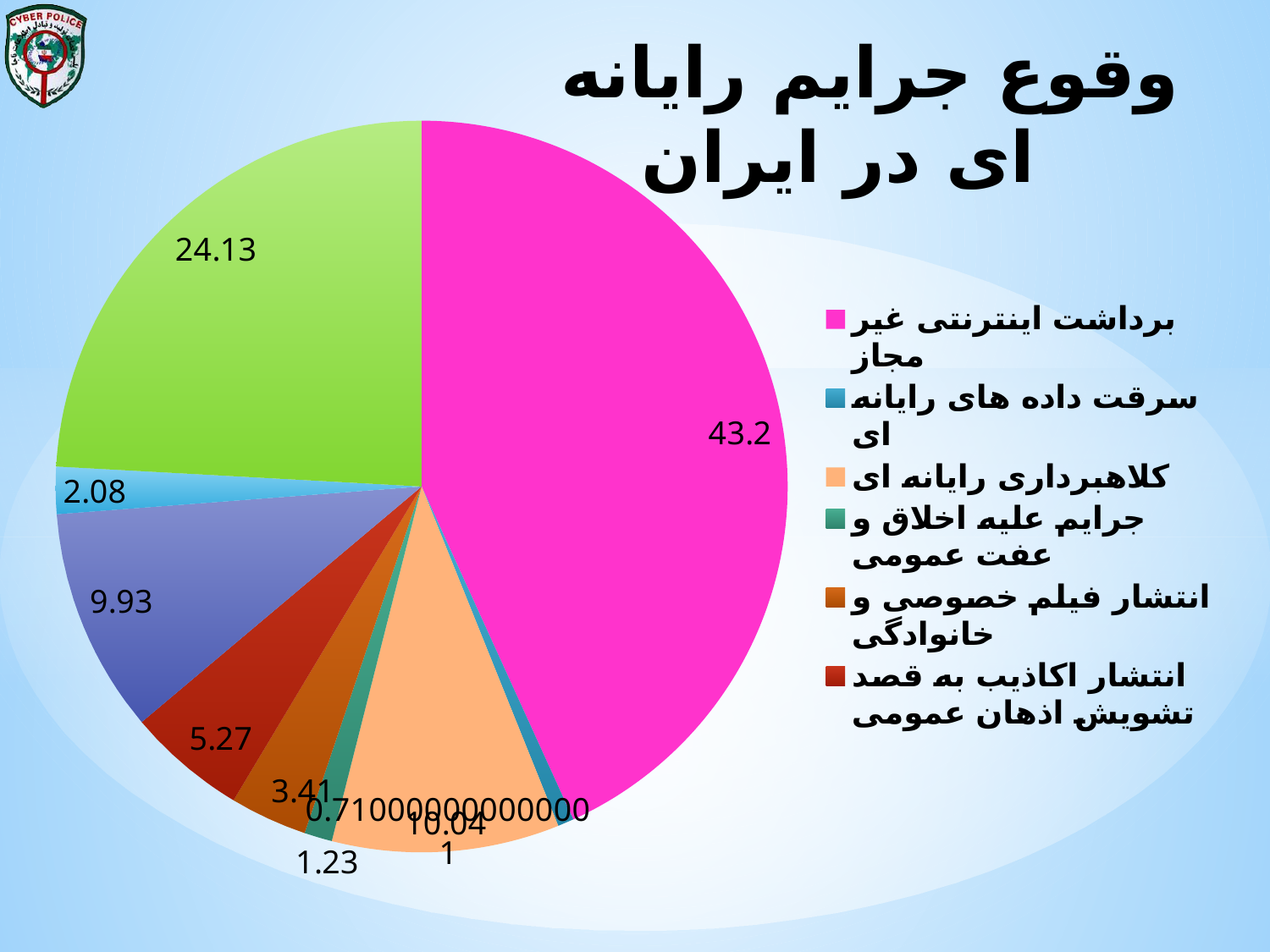
Which is larger, the slice for برداشت اینترنتی غیر مجاز or the slice for کلاهبرداری رایانه ای? برداشت اینترنتی غیر مجاز What kind of chart is shown on the slide? pie chart What is the value shown for انتشار فیلم خصوصی و خانوادگی? 3.41 What is the difference between the values for انتشار اکاذیب به قصد تشویش اذهان عمومی and انتشار فیلم خصوصی و خانوادگی? 1.86 What is the value shown for انتشار اکاذیب به قصد تشویش اذهان عمومی? 5.27 What is the difference between the values for برداشت اینترنتی غیر مجاز and کلاهبرداری رایانه ای? 33.16 What is the value shown for کلاهبرداری رایانه ای? 10.04 What is the title of the chart? وقوع جرایم رایانه ای در ایران What is the value shown for برداشت اینترنتی غیر مجاز? 43.2 How many entries does the legend list? 6 Which legend category has the largest slice of the pie? برداشت اینترنتی غیر مجاز What is the value shown for جرایم علیه اخلاق و عفت عمومی? 1.23